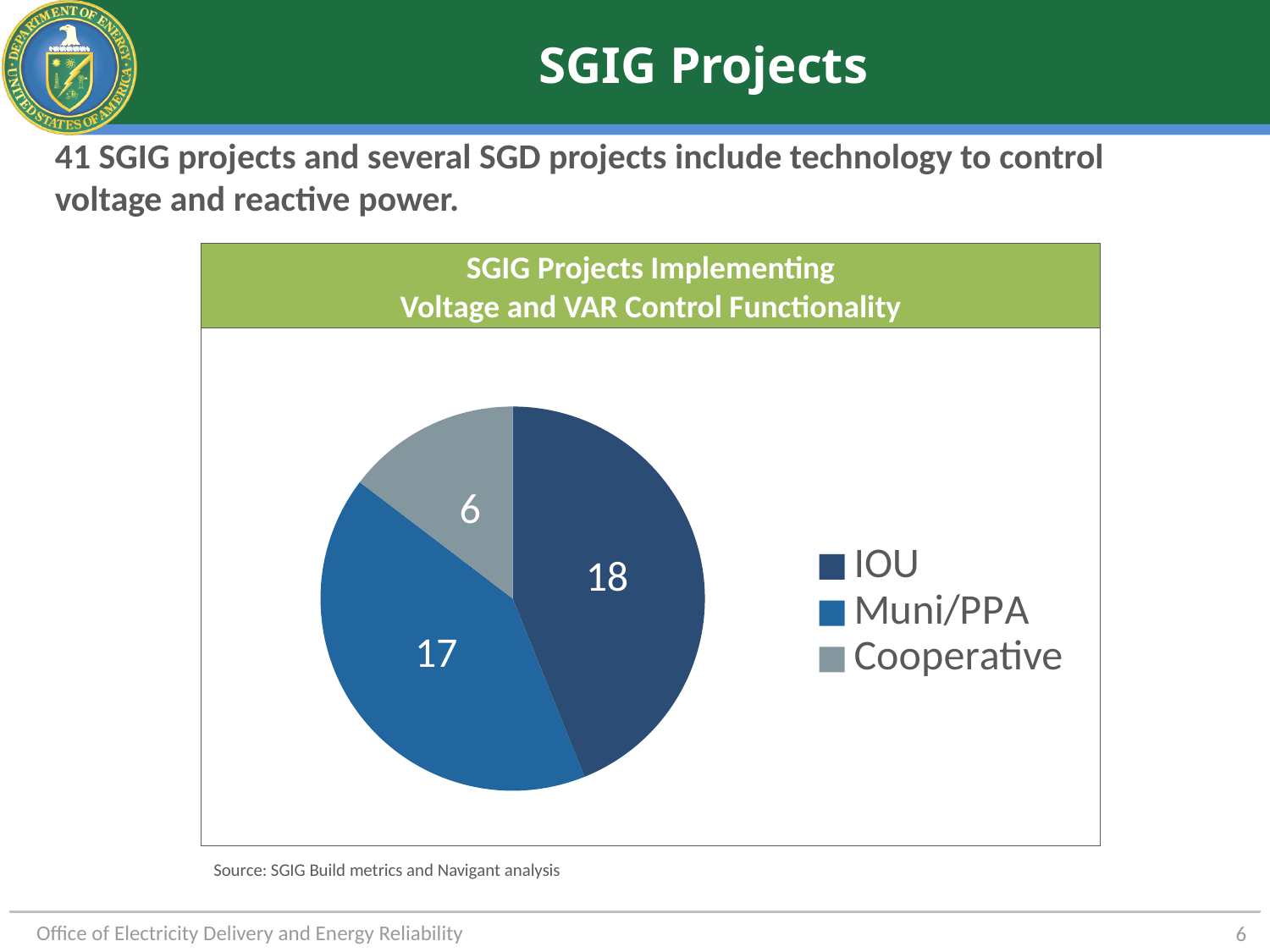
What is the value for Cooperative? 6 What is the title of the chart? SGIG Projects Implementing Voltage and VAR Control Functionality What is the value for IOU? 18 What is the value for Muni/PPA? 17 Which category has the smallest slice? Cooperative How many slices does the pie chart have? 3 What is the difference between the IOU and Cooperative values? 12 Which is larger, the value for Muni/PPA or the value for Cooperative? Muni/PPA How many entries does the legend list? 3 Which category has the largest slice? IOU What is the total of all slices in the pie chart? 41 What type of chart is shown on the slide? pie chart